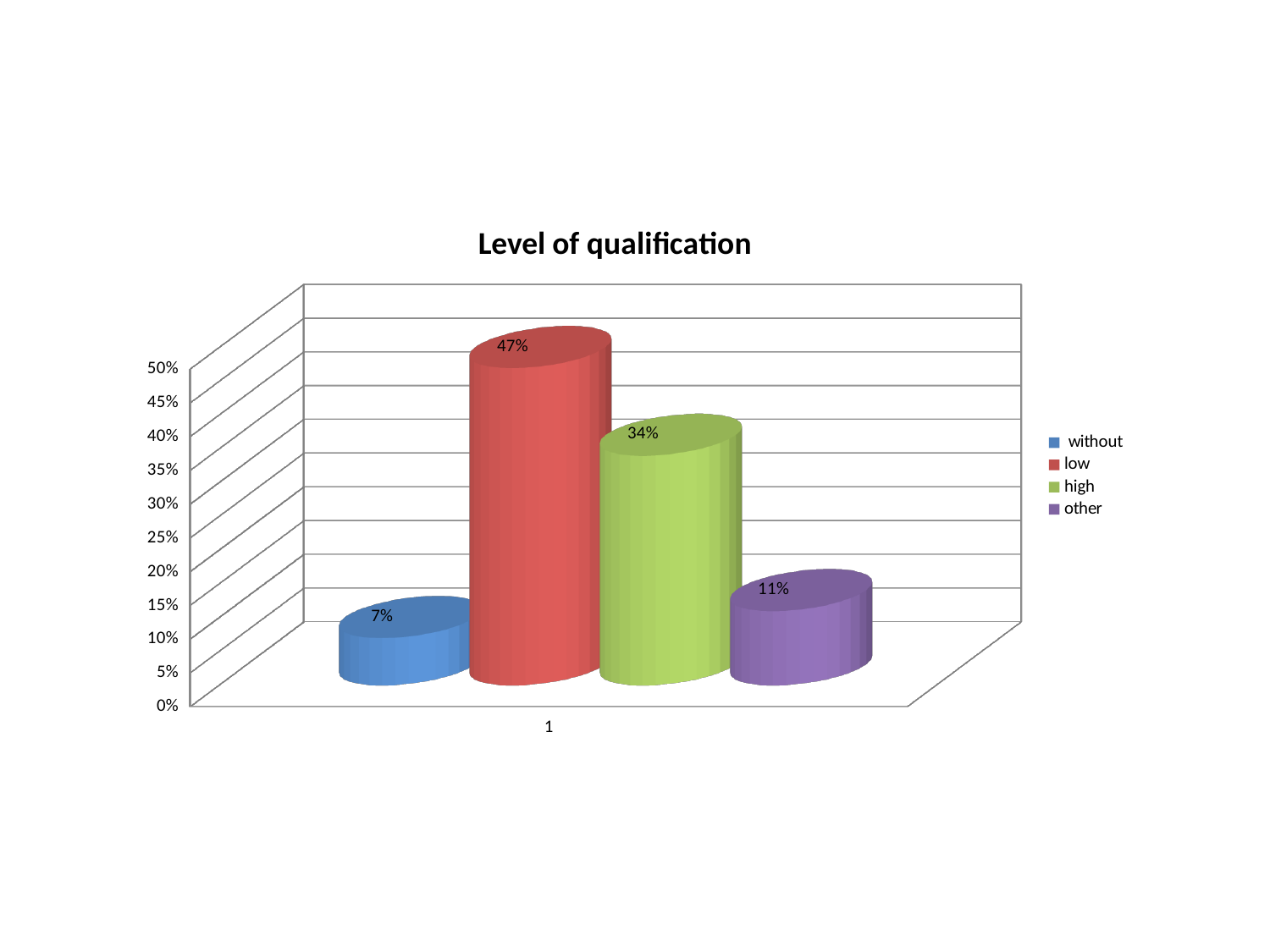
What is the difference between the values for "low" and "high"? 13% What is the difference between the values for "other" and "without"? 4% What is the value for "without" in the Level of qualification chart? 7% What is the value for "other" in the Level of qualification chart? 11% What is the title of the chart? Level of qualification What kind of chart is shown on the slide? bar chart What is the value for "low" in the Level of qualification chart? 47% Which series has the lowest value in the Level of qualification chart? without What is the value for "high" in the Level of qualification chart? 34% How many series does the legend list? 4 Which series has the highest value in the Level of qualification chart? low Which is larger, the value for "high" or the value for "other"? high